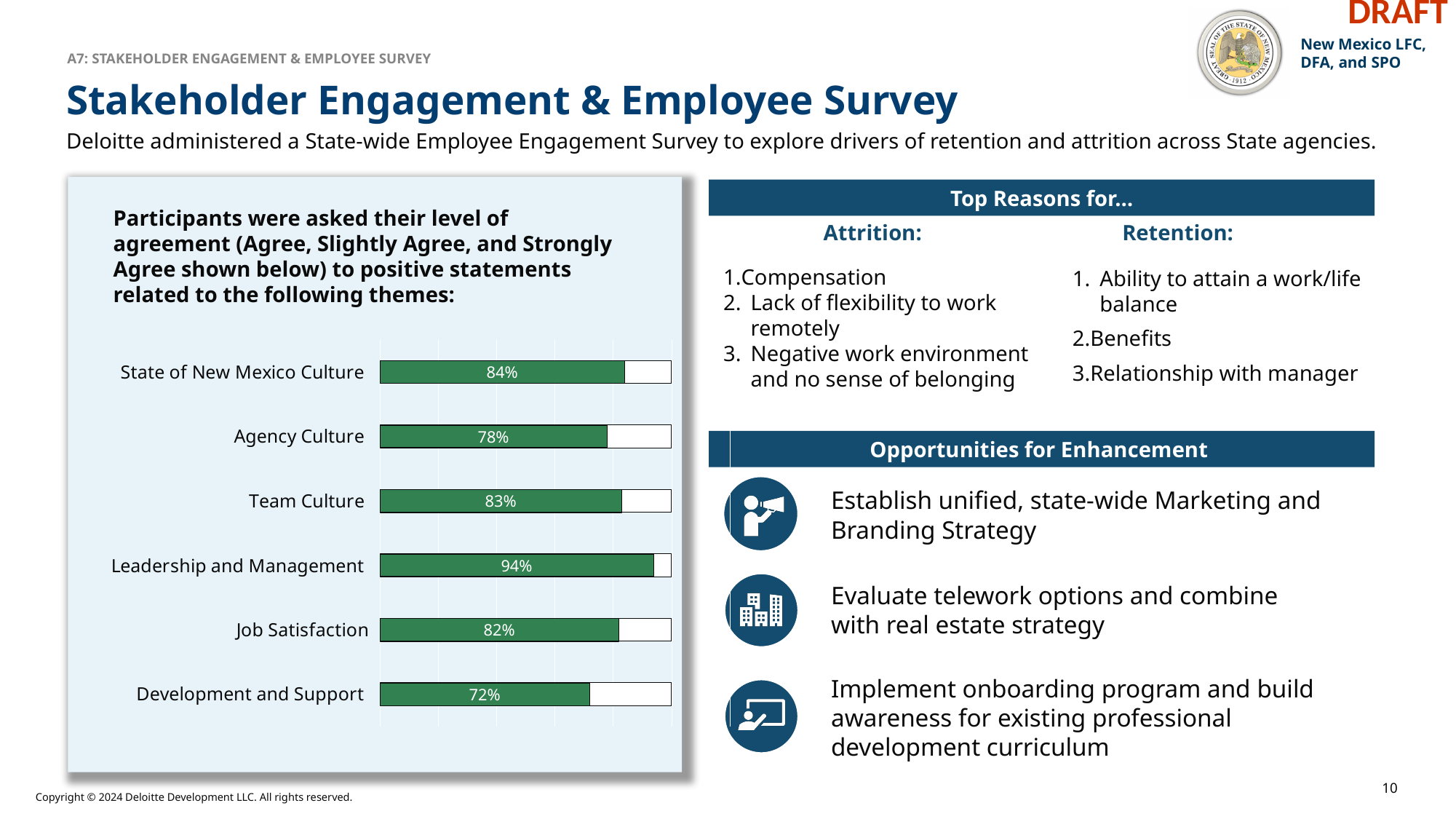
What is the value shown for Leadership and Management? 94% What colour are the bars representing the agreement percentages? Green What kind of chart is shown on the slide? Bar chart What is the value shown for Job Satisfaction? 82% How many themes are shown in the chart? 6 What percentage of participants agreed with positive statements about State of New Mexico Culture? 84% Which theme has the lowest level of agreement? Development and Support What is the difference between the values for Leadership and Management and Development and Support? 22% What is the value shown for Development and Support? 72% What is the difference between the values for State of New Mexico Culture and Agency Culture? 6% Which has a higher value, Team Culture or Agency Culture? Team Culture Which theme has the highest level of agreement? Leadership and Management